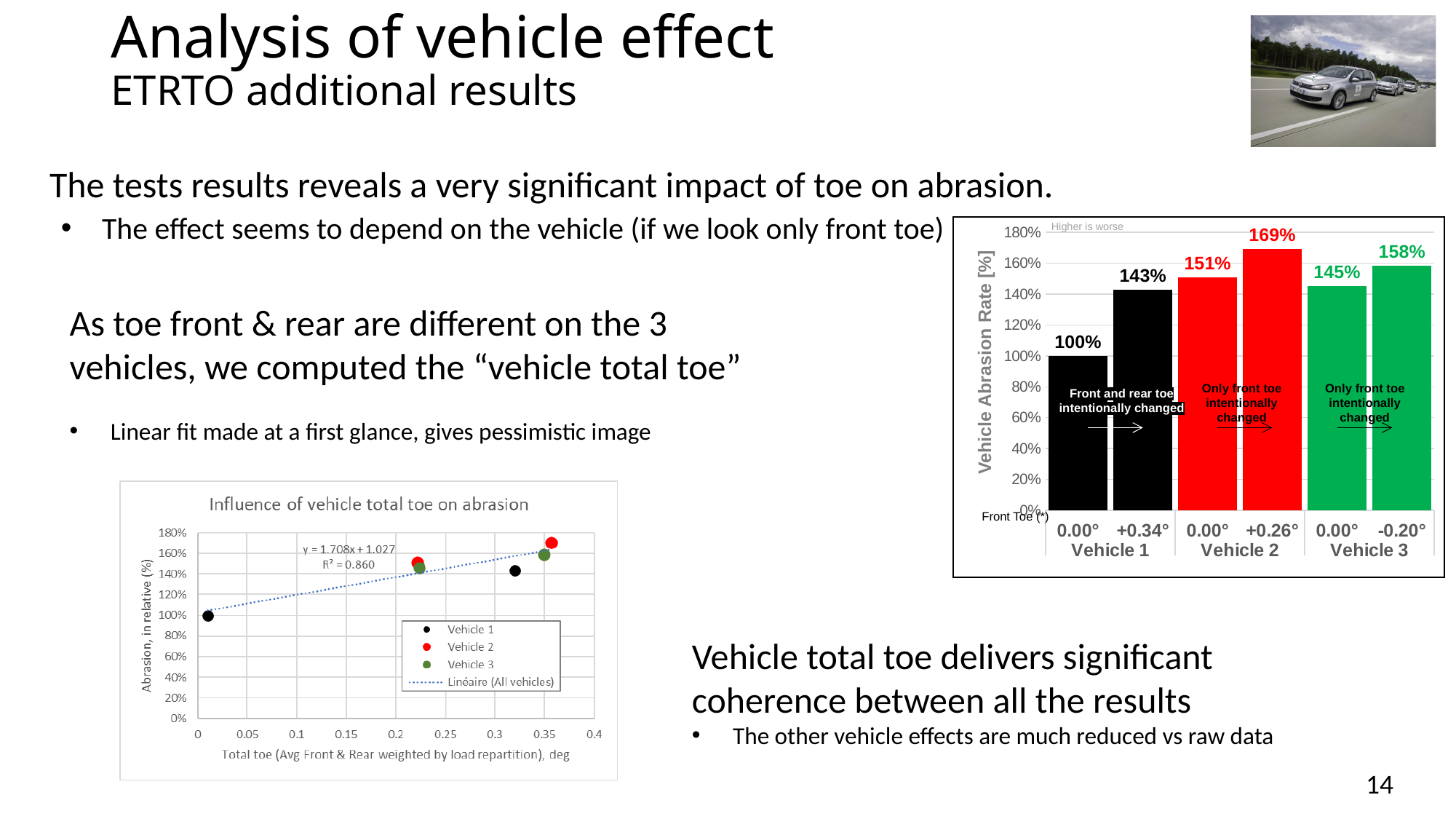
In the bar chart on the right, what is the difference between the abrasion rate of Vehicle 1 at +0.34° and Vehicle 1 at 0.00°? 43% In the bar chart on the right, what is the vehicle abrasion rate for Vehicle 2 at a front toe of +0.26°? 169% How many entries does the legend list in the chart titled 'Influence of vehicle total toe on abrasion'? 4 In the chart titled 'Influence of vehicle total toe on abrasion', does abrasion rise or fall as total toe increases along the x axis? Rise In the bar chart on the right, which bar has the highest vehicle abrasion rate? Vehicle 2 at +0.26° In the bar chart on the right, which bar has the lowest vehicle abrasion rate? Vehicle 1 at 0.00° In the bar chart on the right, what is the vehicle abrasion rate for Vehicle 3 at a front toe of -0.20°? 158% What kind of chart is the chart on the right showing Vehicle Abrasion Rate? Bar chart In the bar chart on the right, what is the vehicle abrasion rate for Vehicle 1 at a front toe of 0.00°? 100% What is the R² value shown in the chart titled 'Influence of vehicle total toe on abrasion'? R² = 0.860 In the bar chart on the right, which is larger: the abrasion rate of Vehicle 2 at 0.00° or Vehicle 3 at 0.00°? Vehicle 2 at 0.00° How many bars are plotted in the bar chart on the right? 6